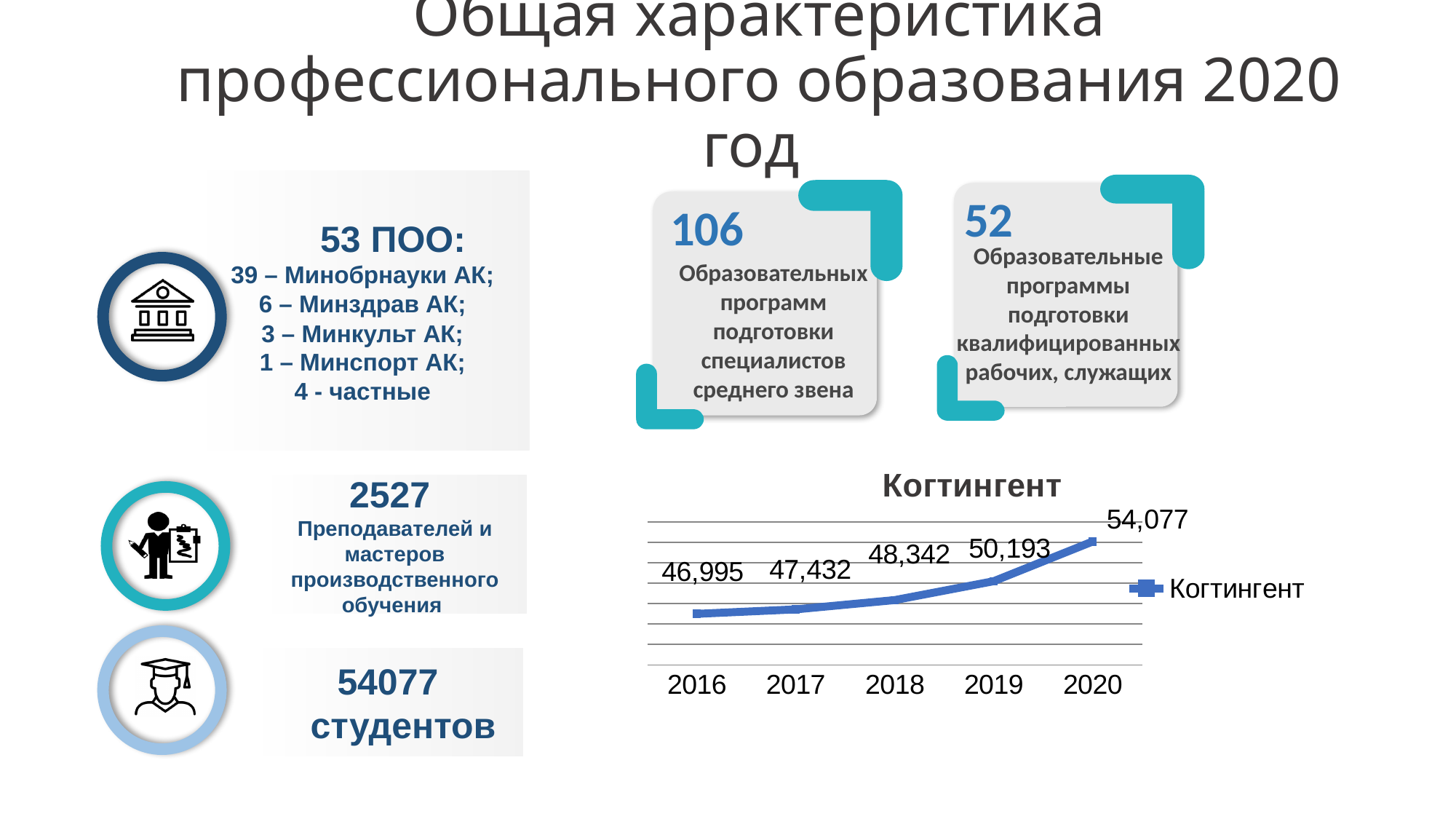
What is the difference between the values for 2017 and 2016? 437 What is the value for 2020 in the chart? 54,077 What is the value for 2018 in the chart? 48,342 What is the value for 2016 in the chart? 46,995 Which year has the highest value in the chart? 2020 Which year has the lowest value in the chart? 2016 Do the values rise or fall from 2016 to 2020? rise What type of chart is shown on the slide? line chart How many years are plotted in the chart? 5 What is the difference between the values for 2020 and 2019? 3,884 What is the title of the chart? Когтингент Which is larger, the value for 2019 or the value for 2018? 2019